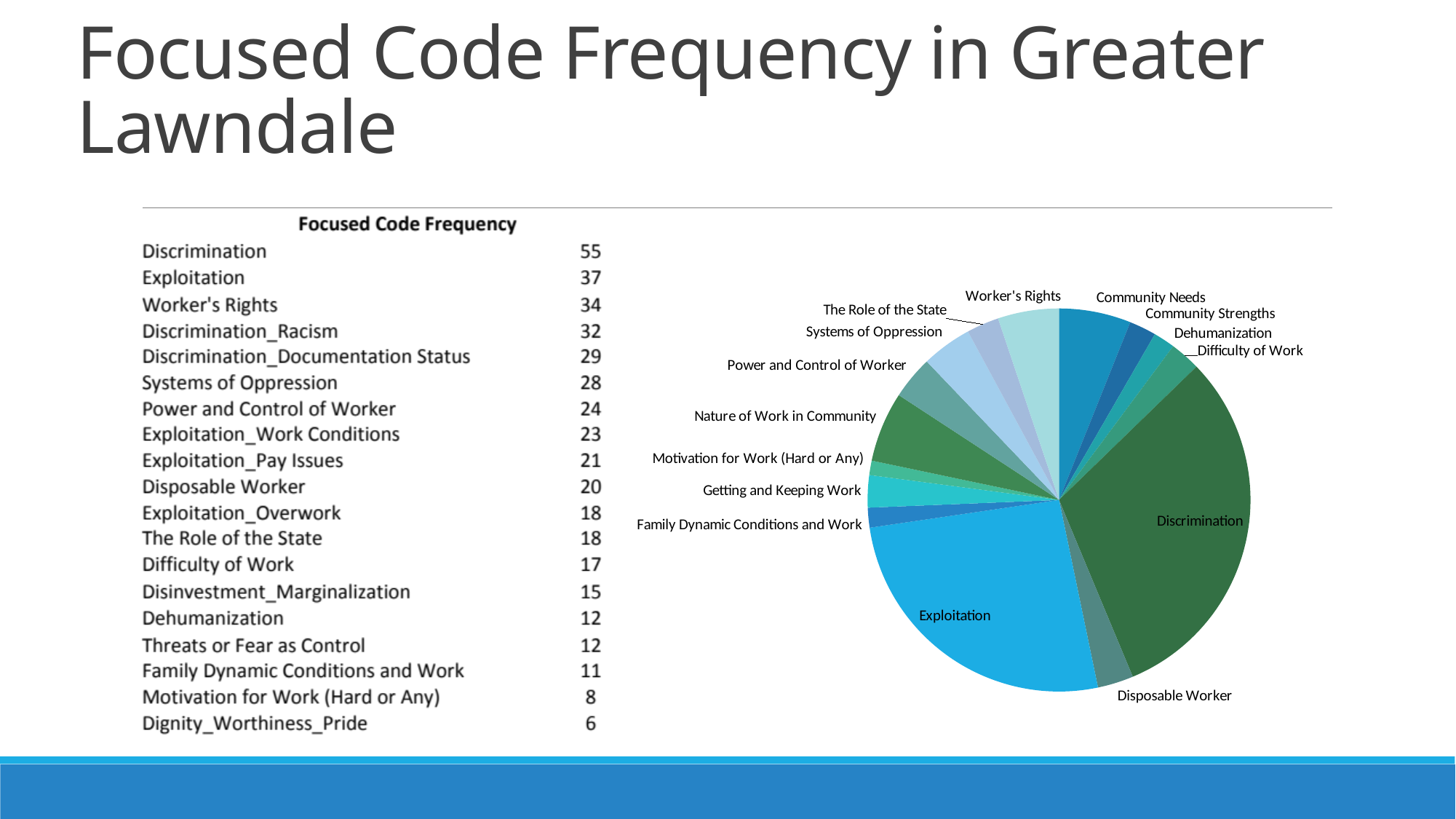
In the pie chart, which slice is larger: Discrimination or Exploitation? Discrimination What kind of chart is shown on the right of the slide? pie chart Does the pie chart include a legend? No In the pie chart, which slice is larger: Exploitation or Disposable Worker? Exploitation According to the table on the left, what is the difference between the frequencies for Discrimination and Worker's Rights? 21 How many labeled slices does the pie chart have? 15 In the pie chart, which slice is larger: Systems of Oppression or Motivation for Work (Hard or Any)? Systems of Oppression According to the table on the left, what is the frequency for Discrimination? 55 What is the title of the slide? Focused Code Frequency in Greater Lawndale In the pie chart, which category has the largest slice? Discrimination According to the table on the left, what is the frequency for Exploitation? 37